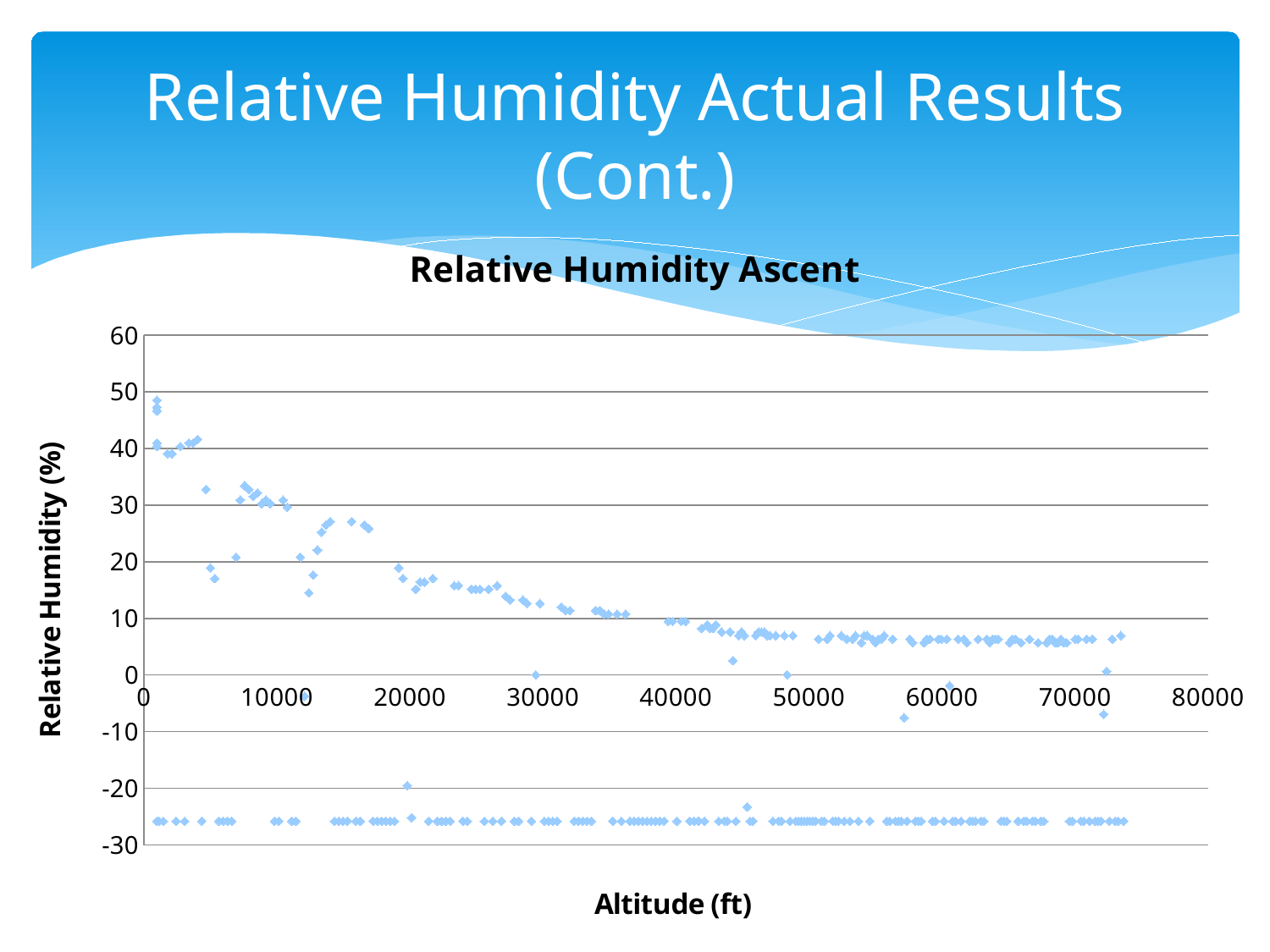
Do the relative humidity values in the main cluster of points rise or fall as altitude increases? fall Are the relative humidity values in the main cluster at altitudes near 40000 ft greater or less than 20? less What is the label of the x axis of the chart? Altitude (ft) What kind of chart is shown on the slide? scatter chart Are the relative humidity values in the main cluster at altitudes near 70000 ft greater or less than 10? less Is the row of points running along the bottom of the chart greater or less than -20? less What is the title of the chart? Relative Humidity Ascent